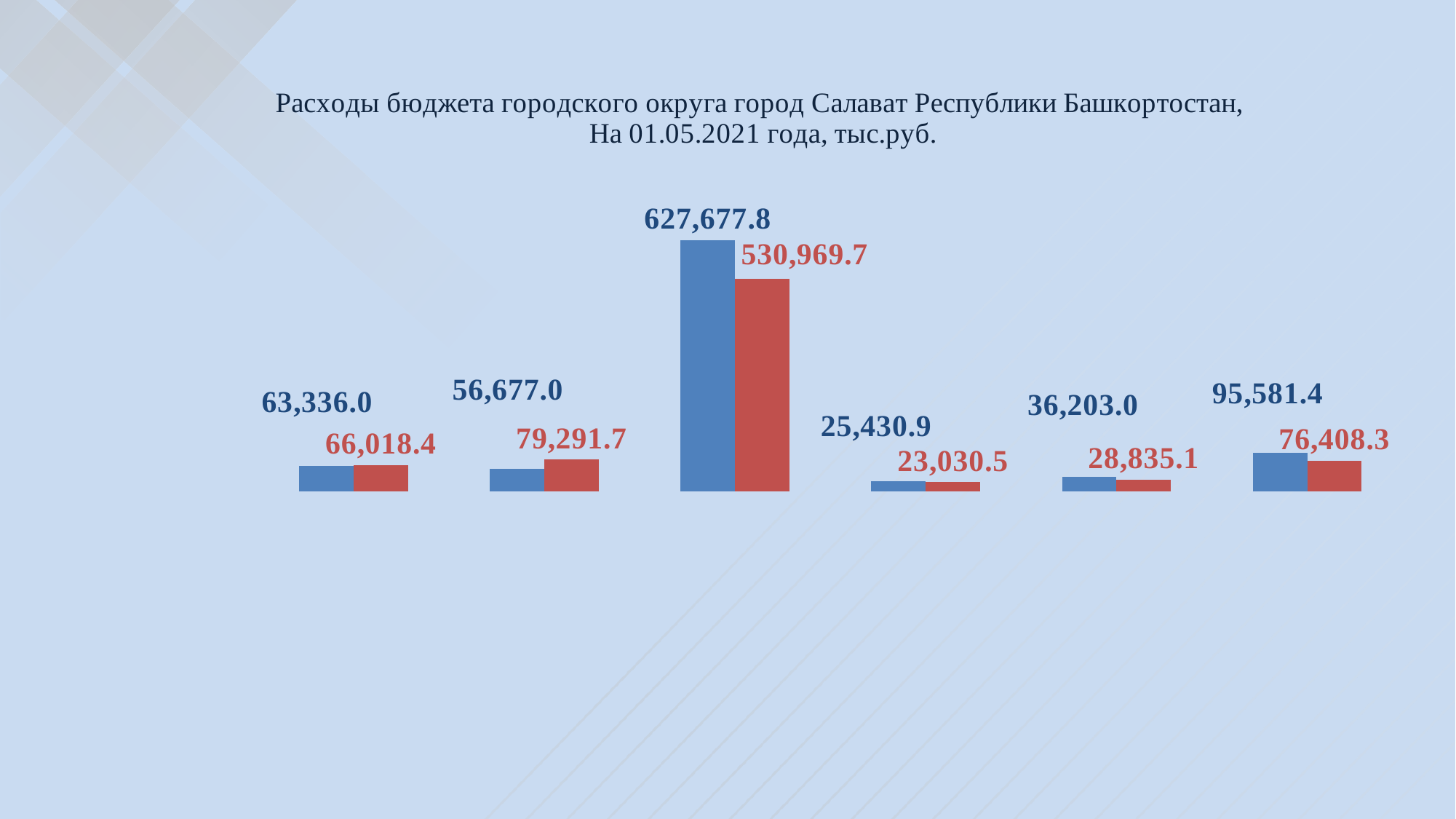
In what units are the values in the chart expressed, according to the title? тыс.руб. What kind of chart is shown on the slide? bar chart What is the lowest value shown among the red bars? 23,030.5 What is the highest value shown among the blue bars? 627,677.8 In the second group from the left, which bar is larger, the blue one or the red one? red What is the value of the red bar in the rightmost group? 76,408.3 How many data series (bar colours) are plotted in the chart? 2 In the rightmost group, how much larger is the blue bar (95,581.4) than the red bar (76,408.3)? 19,173.1 What is the value of the blue bar in the leftmost group? 63,336.0 In the third group from the left, what is the difference between the blue bar (627,677.8) and the red bar (530,969.7)? 96,708.1 How many groups of bars are plotted in the chart? 6 What is the value of the blue bar in the fifth group from the left? 36,203.0